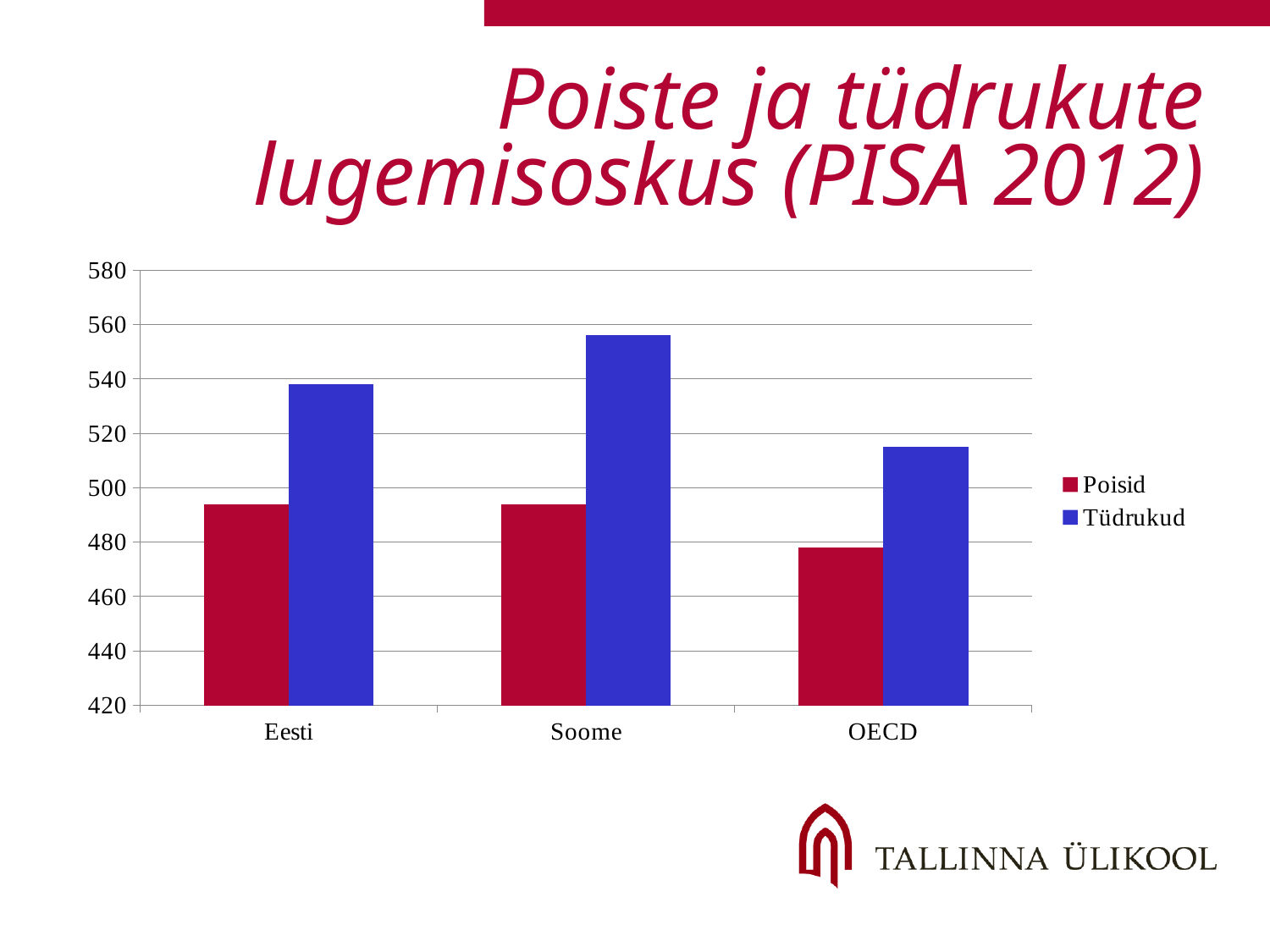
Is the value for Tüdrukud in Eesti greater or less than 520? greater How many series does the legend list? 2 Which category has the lowest value for Poisid? OECD Which category has the highest value for Tüdrukud? Soome Is the value for Tüdrukud in Soome greater or less than 540? greater What colour are the bars for the Poisid series? red What kind of chart is shown on the slide? bar chart How many categories are shown on the x axis? 3 In Soome, which is larger: the value for Poisid or the value for Tüdrukud? Tüdrukud Is the value for Poisid in OECD greater or less than 500? less Which category has the lowest value for Tüdrukud? OECD